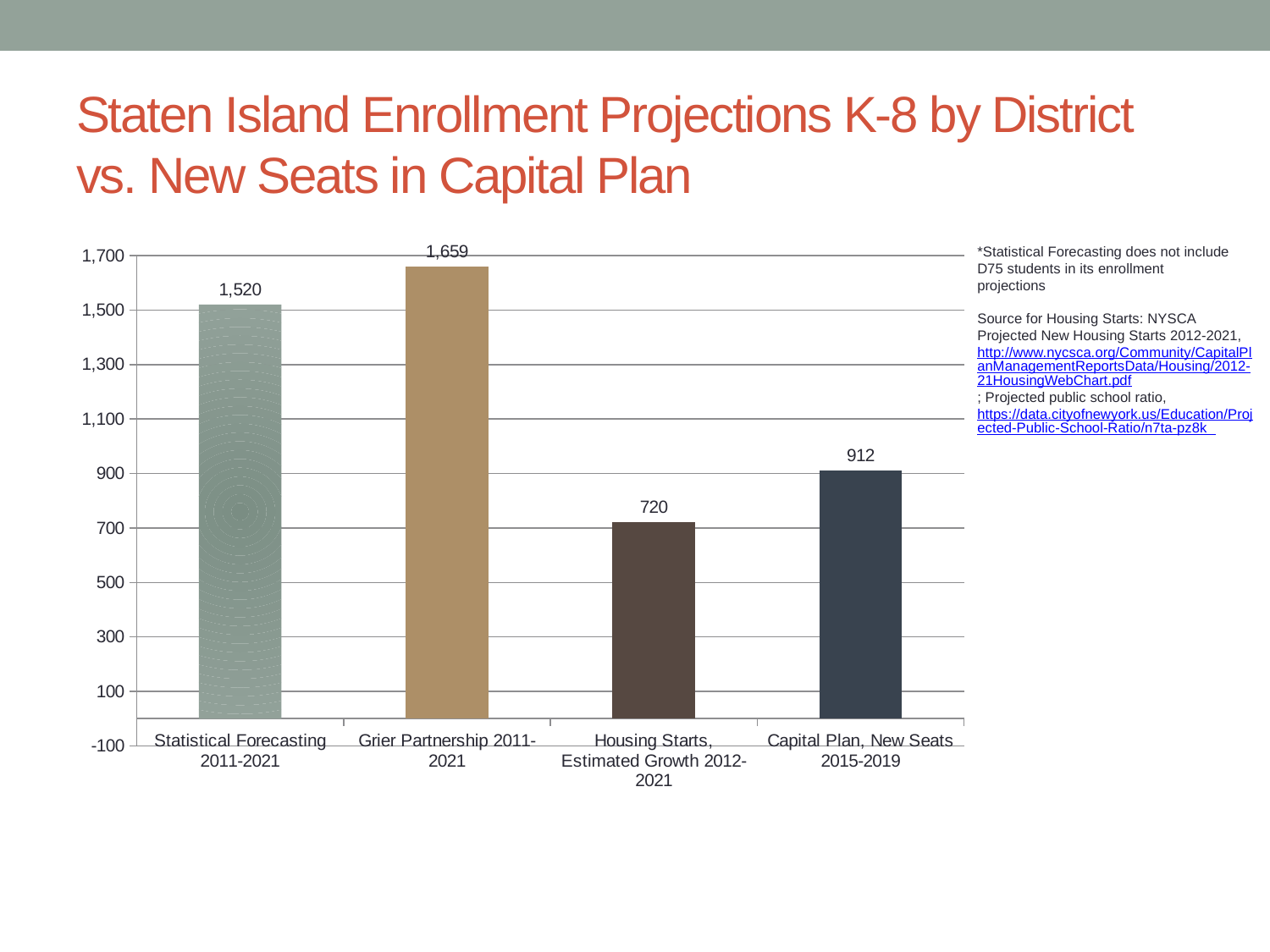
Which category has the highest value? Grier Partnership 2011-2021 What is the value for Capital Plan, New Seats 2015-2019? 912 What is the value for Grier Partnership 2011-2021? 1,659 What is the difference between the Grier Partnership 2011-2021 value and the Statistical Forecasting 2011-2021 value? 139 What kind of chart is shown on the slide? bar chart What is the difference between the Capital Plan, New Seats 2015-2019 value and the Housing Starts, Estimated Growth 2012-2021 value? 192 What is the value for Statistical Forecasting 2011-2021? 1,520 How many categories are shown on the chart? 4 What is the value for Housing Starts, Estimated Growth 2012-2021? 720 Which category has the lowest value? Housing Starts, Estimated Growth 2012-2021 Which is larger, the value for Capital Plan, New Seats 2015-2019 or the value for Housing Starts, Estimated Growth 2012-2021? Capital Plan, New Seats 2015-2019 Is the value for Capital Plan, New Seats 2015-2019 greater or less than 1,100? less